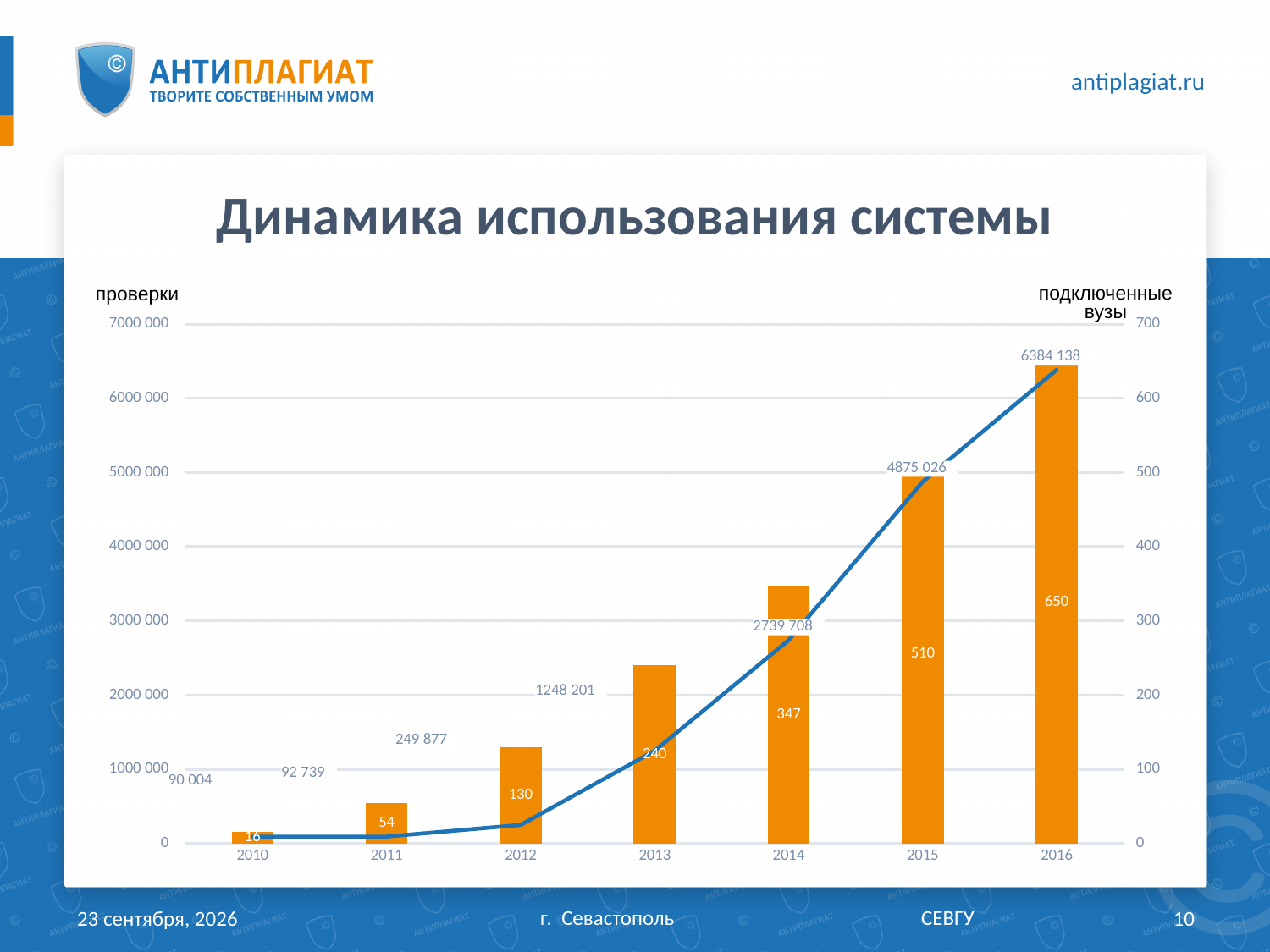
Which year has more connected universities, 2012 or 2013? 2013 Which year has the highest number of connected universities? 2016 What is the title of the chart? Динамика использования системы What is the number of checks shown for 2012? 249 877 Do the number of connected universities rise or fall from 2010 to 2016? rise Is the number of checks for 2014 greater or less than 2000 000? greater What is the number of connected universities (подключенные вузы) shown for 2016? 650 Which year has the lowest number of checks? 2010 How many years are shown on the x axis of the chart? 7 What is the difference in connected universities between 2015 and 2014? 163 What is the number of connected universities shown for 2013? 240 What is the number of checks (проверки) shown for 2015? 4875 026